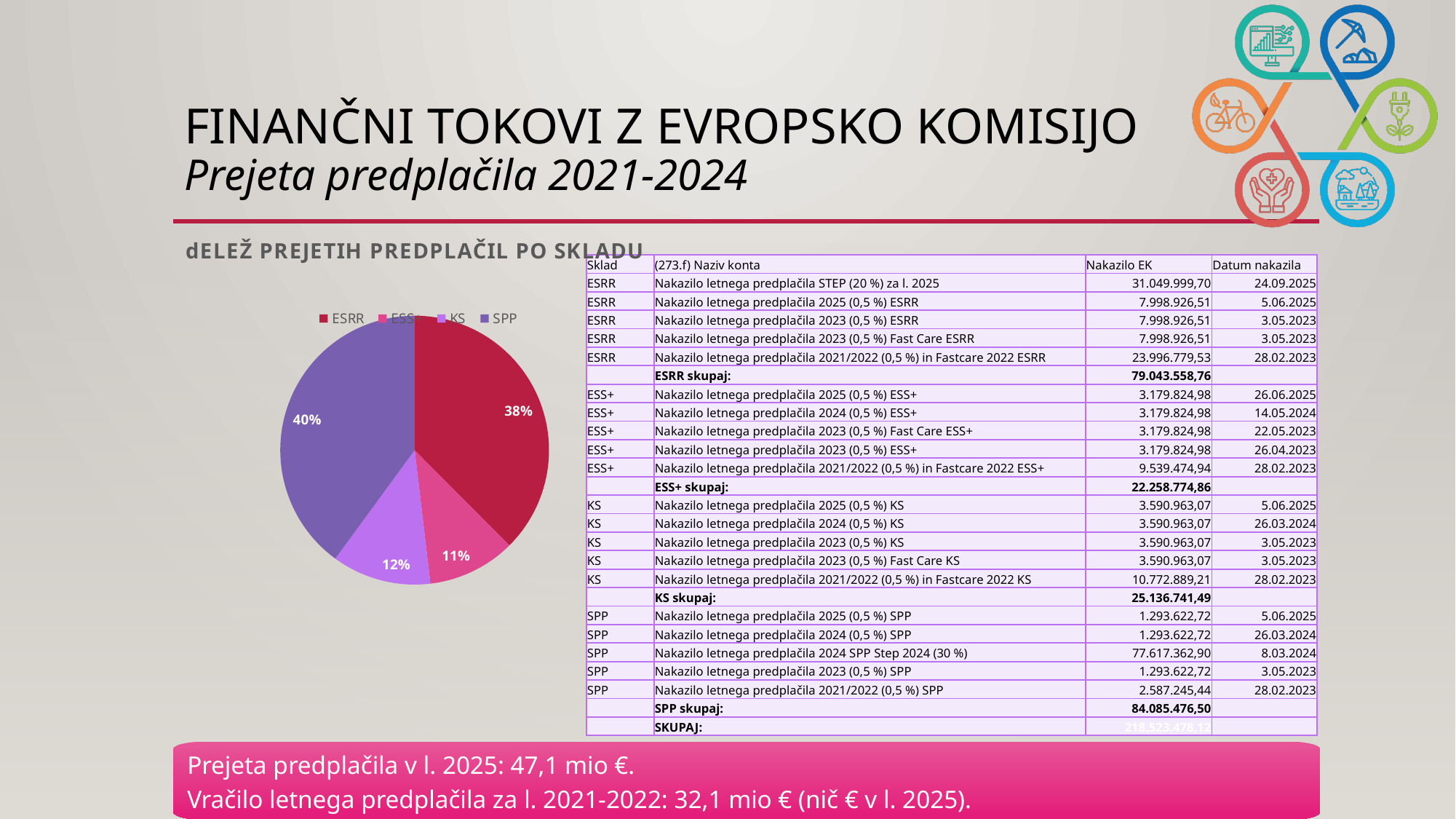
How many slices does the pie chart have? 4 What share of the pie chart does KS have? 12% Which fund has the smallest slice of the pie chart? ESS+ Which fund has the largest slice of the pie chart? SPP Which slice is larger, KS or ESS+? KS What is the title of the pie chart? dELEŽ PREJETIH PREDPLAČIL PO SKLADU What kind of chart is shown on the slide? pie chart What is the difference in percentage points between the ESRR slice and the KS slice? 26 What share of the pie chart does SPP have? 40% What is the difference in percentage points between the SPP slice and the ESRR slice? 2 What share of the pie chart does ESRR have? 38% What share of the pie chart does ESS+ have? 11%